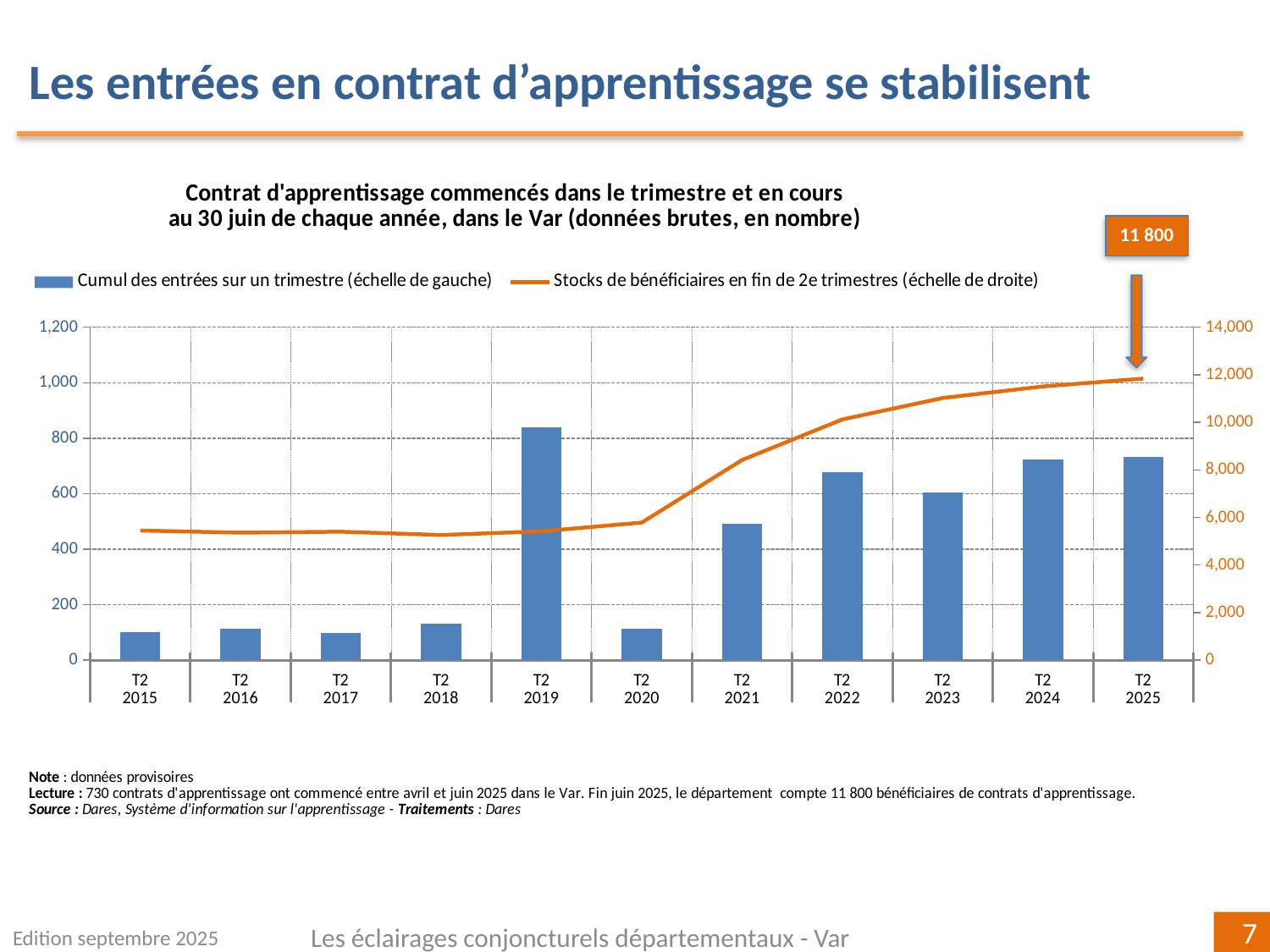
How many series does the legend list? 2 Is the bar value for T2 2019 greater or less than 600? greater Which bar is larger, T2 2019 or T2 2021? T2 2019 Does the 'Stocks de bénéficiaires' line rise or fall between T2 2020 and T2 2025? It rises How many quarters (categories) are shown on the x axis? 11 What kind of chart is shown on the slide? A combined bar and line chart In which quarter is the bar for 'Cumul des entrées sur un trimestre' the highest? T2 2019 Is the bar value for T2 2021 greater or less than 600? less Is the stock of beneficiaries at T2 2015 greater or less than 6,000 on the right-hand axis? less What is the value of the stock of beneficiaries (Stocks de bénéficiaires) at T2 2025? 11 800 What colour is the line for 'Stocks de bénéficiaires en fin de 2e trimestres'? Orange